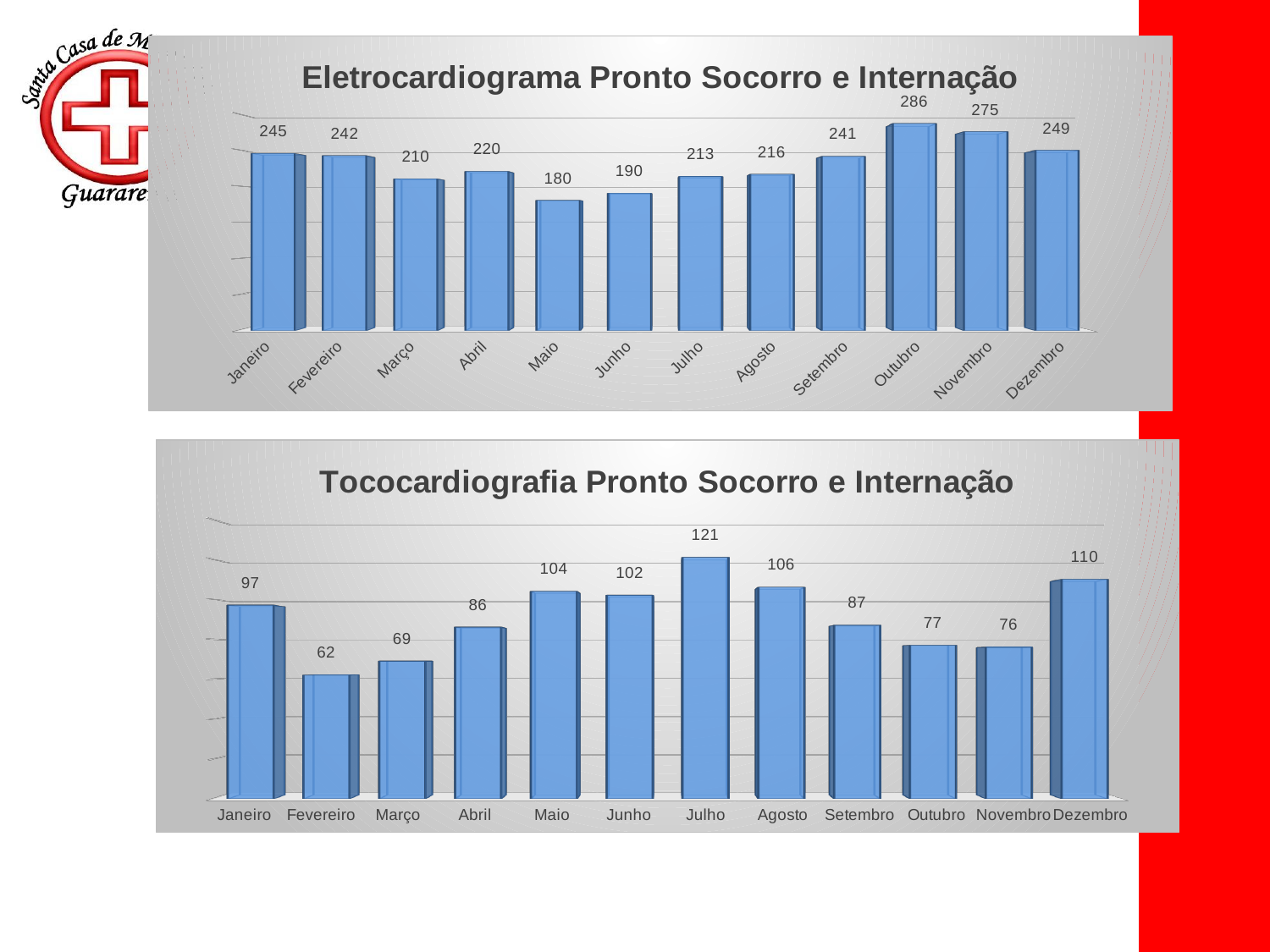
How many months are shown in the 'Eletrocardiograma Pronto Socorro e Internação' chart? 12 In the 'Tococardiografia Pronto Socorro e Internação' chart, which month has the lowest value? Fevereiro In the 'Tococardiografia Pronto Socorro e Internação' chart, what is the difference between Dezembro and Novembro? 34 In the 'Tococardiografia Pronto Socorro e Internação' chart, which month has the highest value? Julho In the 'Eletrocardiograma Pronto Socorro e Internação' chart, what is the value for Outubro? 286 In the 'Eletrocardiograma Pronto Socorro e Internação' chart, which month has the lowest value? Maio In the 'Tococardiografia Pronto Socorro e Internação' chart, do the values rise or fall from Janeiro to Fevereiro? Fall In the 'Eletrocardiograma Pronto Socorro e Internação' chart, what is the difference between Outubro and Maio? 106 What kind of chart is the 'Tococardiografia Pronto Socorro e Internação' chart? Bar chart What is the title of the top chart on the slide? Eletrocardiograma Pronto Socorro e Internação In the 'Tococardiografia Pronto Socorro e Internação' chart, what is the value for Julho? 121 In the 'Eletrocardiograma Pronto Socorro e Internação' chart, which is larger, Janeiro or Dezembro? Dezembro